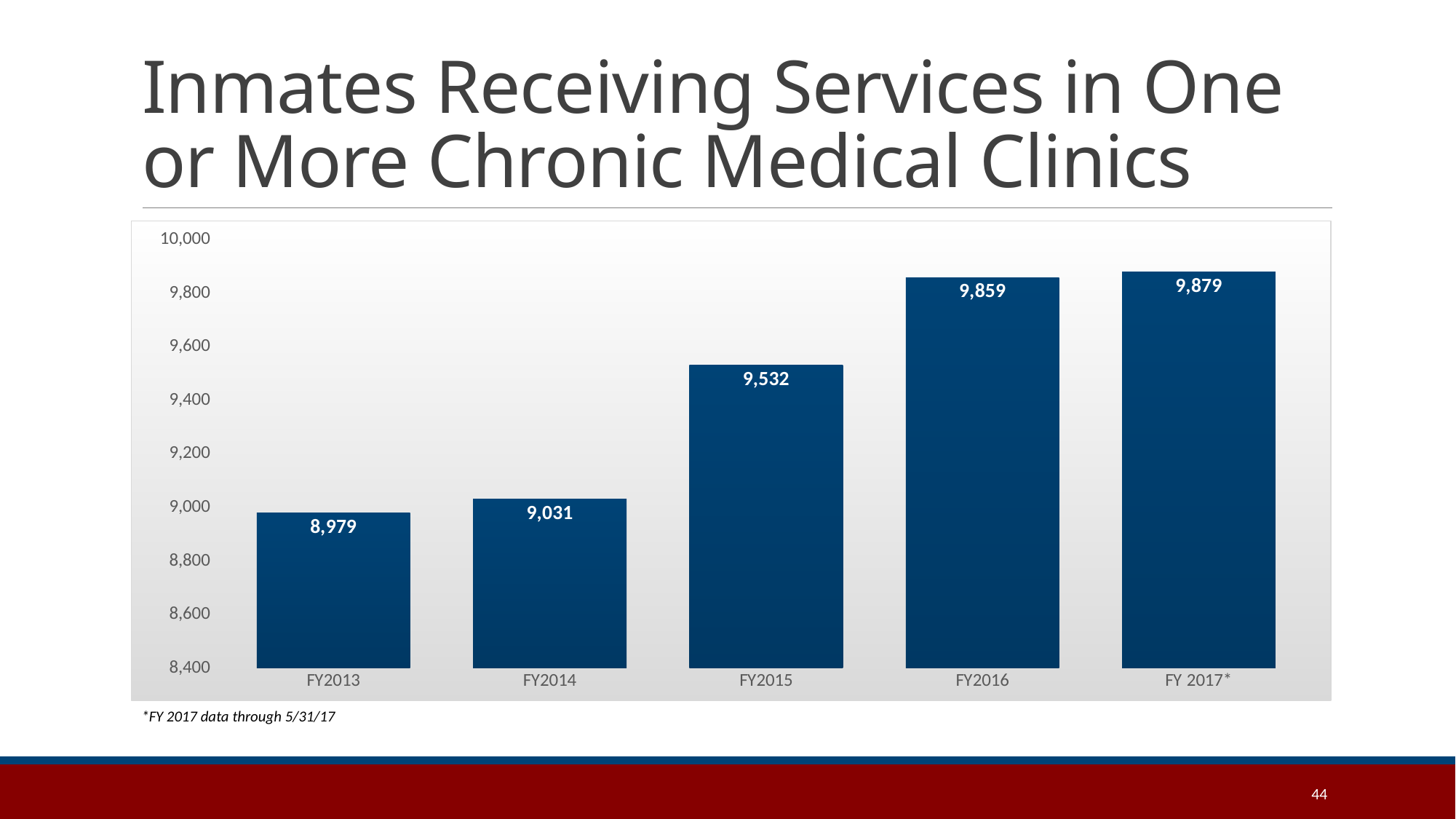
What is the value for FY2013? 8,979 Which fiscal year has the lowest value? FY2013 Which is larger, the value for FY2015 or the value for FY2014? FY2015 How many fiscal years are shown on the chart? 5 Which fiscal year has the highest value? FY 2017* What is the difference between the values for FY2016 and FY2015? 327 What is the value for FY2015? 9,532 Do the values rise or fall from FY2013 to FY 2017*? Rise What kind of chart is shown on the slide? Bar chart Is the value for FY2016 greater or less than 9,800? greater What is the value for FY 2017*? 9,879 What is the difference between the values for FY2014 and FY2013? 52